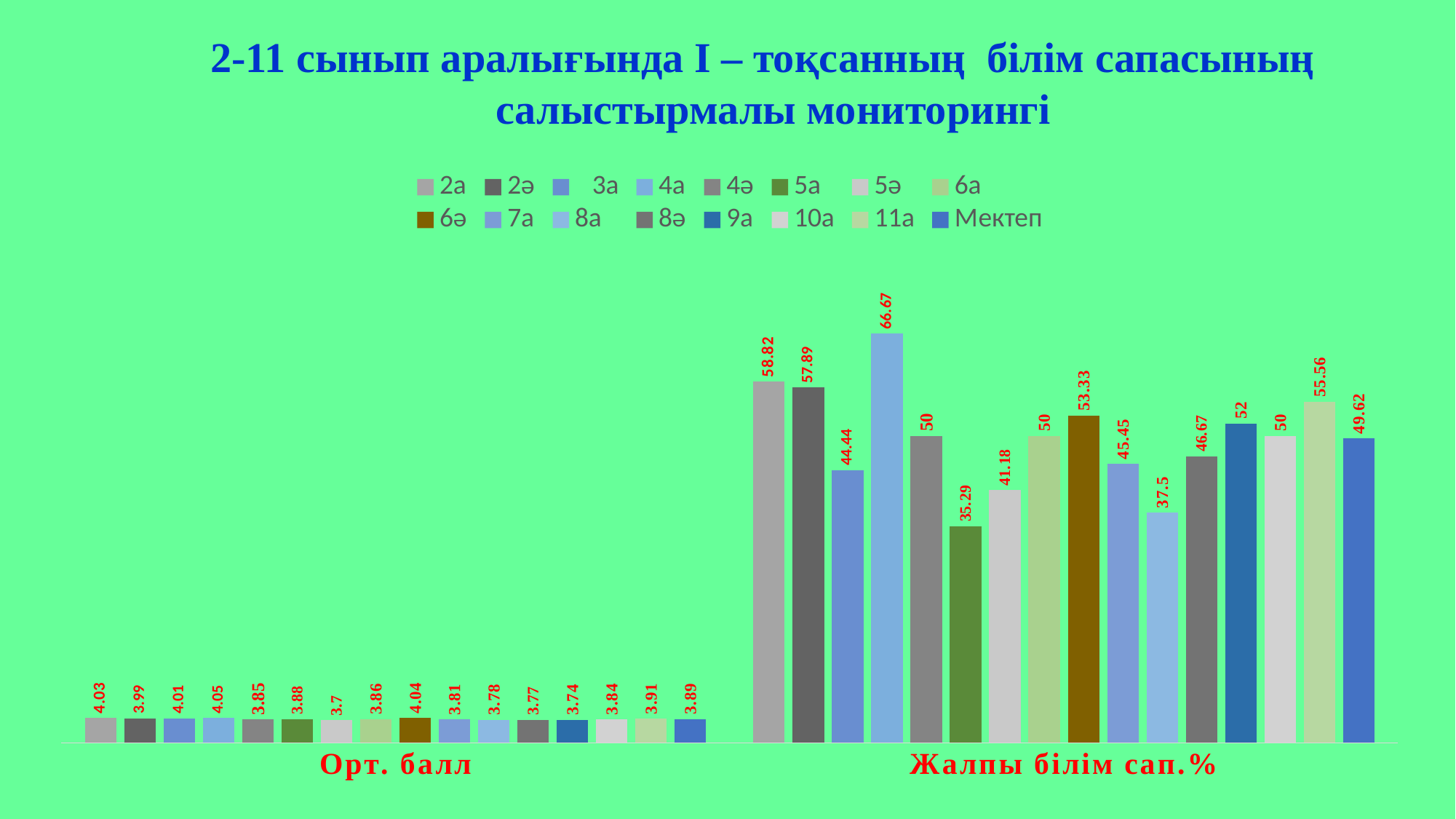
What is the difference between the values for 2а and 2ә in the Жалпы білім сап.% category? 0.93 What is the value for Мектеп in the Орт. балл category? 3.89 What is the value for 6ә in the Жалпы білім сап.% category? 53.33 In the Жалпы білім сап.% category, which is larger: the value for 11а or the value for 9а? 11а What kind of chart is shown on the slide? bar chart How many series does the legend list? 16 What is the label of the last entry in the legend? Мектеп Which series has the highest value in the Жалпы білім сап.% category? 4а Which series has the lowest value in the Жалпы білім сап.% category? 5а Which series has the lowest value in the Орт. балл category? 5ә What is the value for 4а in the Жалпы білім сап.% category? 66.67 How many categories are shown on the x axis? 2